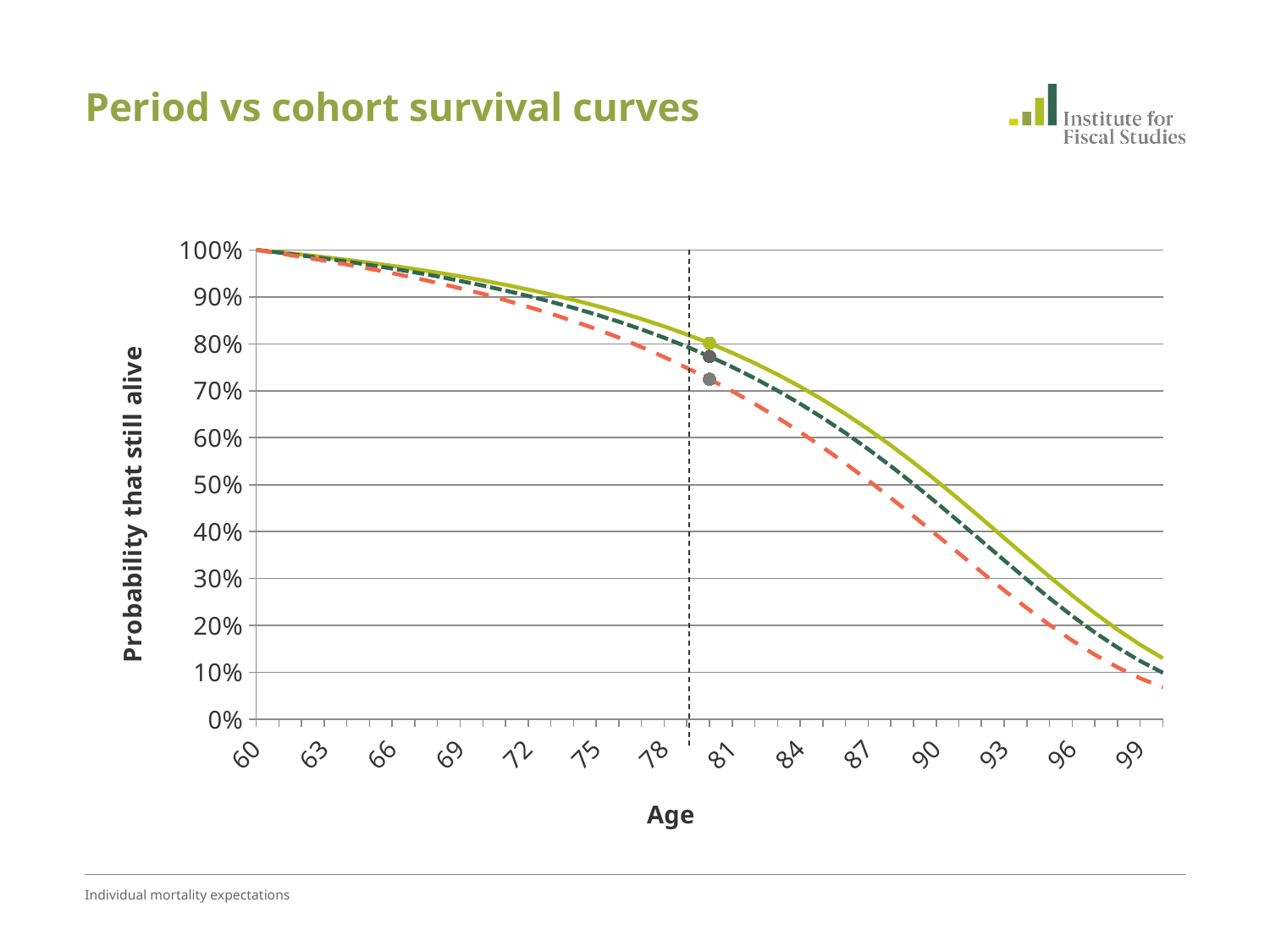
What is the value of the survival curves at age 60? 100% Do the plotted values rise or fall as age increases along the x axis? Fall What is the label on the vertical axis of the chart? Probability that still alive Which of the three lines is highest at age 93? The solid green line How many age labels are shown along the x axis? 14 What is the title of the chart? Period vs cohort survival curves How many lines are plotted on the chart? 3 Is the value of the solid green line at age 69 greater or less than 90%? greater Is the value of the dashed orange line at age 66 greater or less than 90%? greater Is the value of the solid green line at age 99 greater or less than 20%? less What kind of chart is shown on the slide? Line chart Which line is the lowest at age 90: the solid green line or the dashed orange line? The dashed orange line